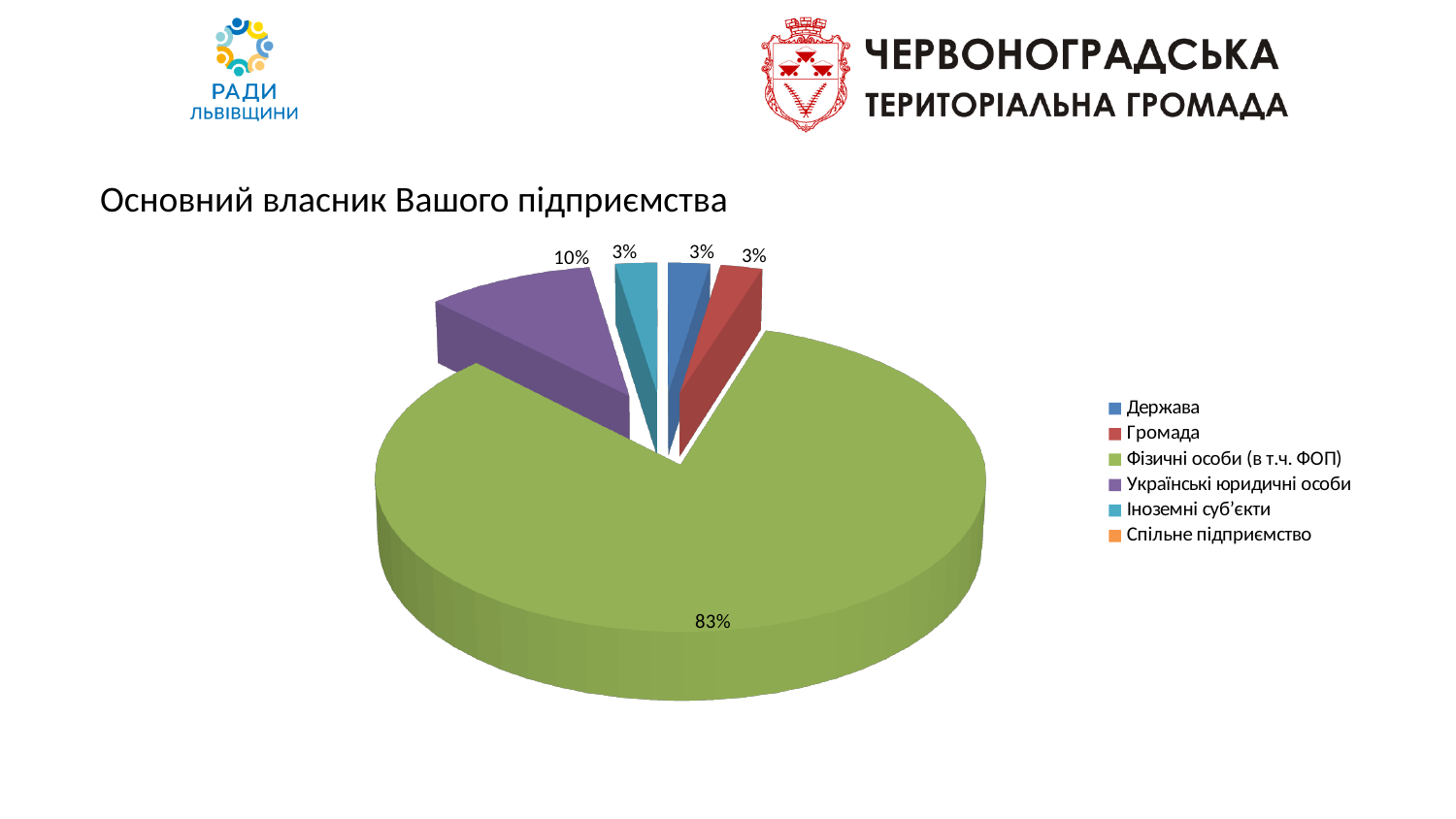
What is the title of the chart? Основний власник Вашого підприємства What share of the pie is labelled for Іноземні суб'єкти? 3% What share of the pie is labelled for Українські юридичні особи? 10% Which is larger, the slice for Українські юридичні особи or the slice for Громада? Українські юридичні особи What kind of chart is shown on the slide? Pie chart What is the difference between the share for Фізичні особи (в т.ч. ФОП) and the share for Українські юридичні особи? 73% What share of the pie is labelled for Фізичні особи (в т.ч. ФОП)? 83% Is the share for Фізичні особи (в т.ч. ФОП) greater or less than 50%? greater What colour is the slice for Українські юридичні особи? Purple How many categories does the legend list? 6 Which category has the largest slice of the pie? Фізичні особи (в т.ч. ФОП)